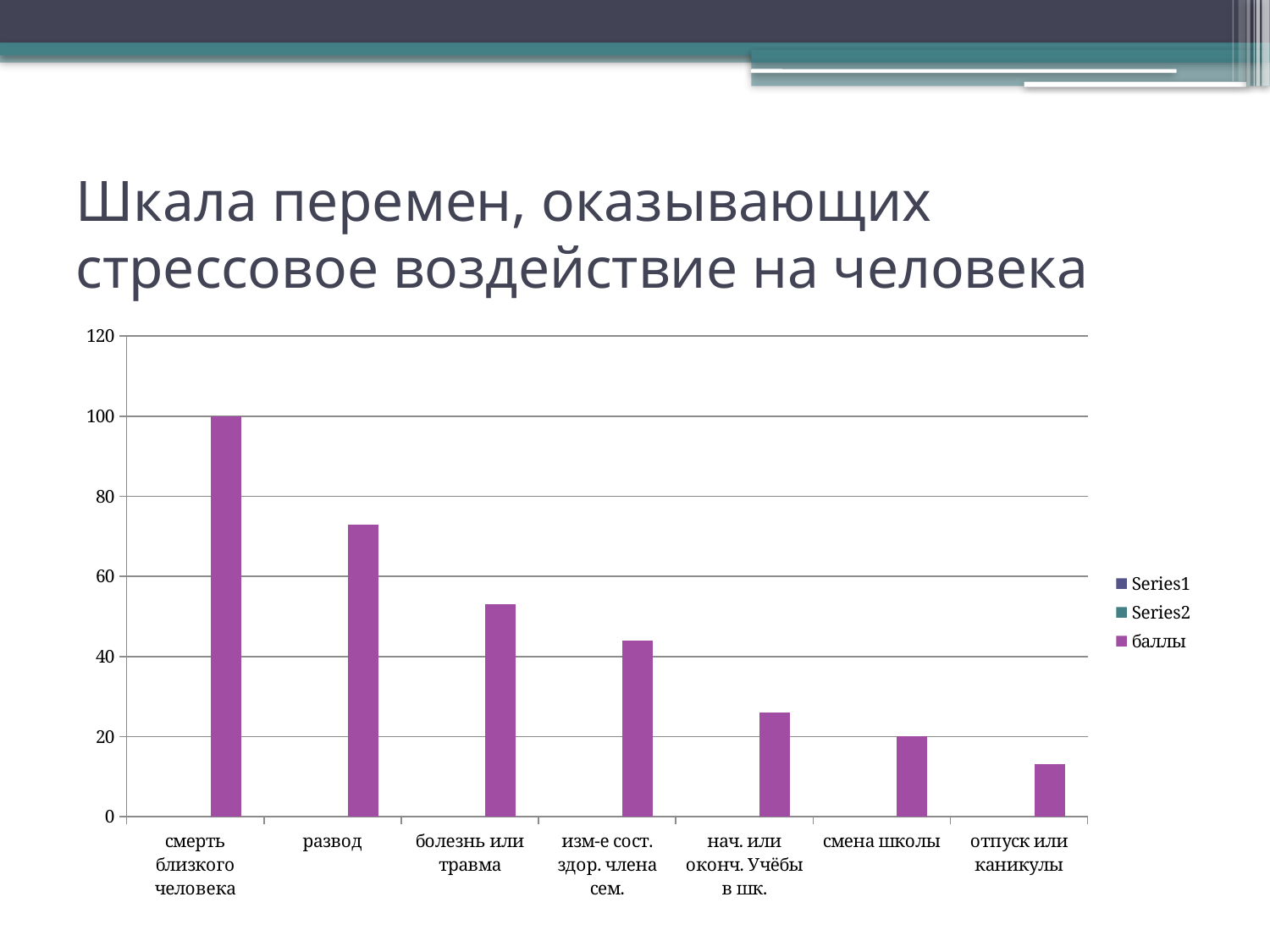
How many series does the legend list? 3 Is the value for болезнь или травма greater or less than 60? less How many categories are shown on the x axis of the chart? 7 Do the values rise or fall from left to right along the x axis? fall Is the value for нач. или оконч. Учёбы в шк. greater or less than 40? less Is the value for развод greater or less than 60? greater Which is larger, the value for изм-е сост. здор. члена сем. or the value for смена школы? изм-е сост. здор. члена сем. What is the value for смена школы? 20 What type of chart is shown on the slide? bar chart Which category has the highest value? смерть близкого человека What is the value for смерть близкого человека? 100 Which category has the lowest value? отпуск или каникулы